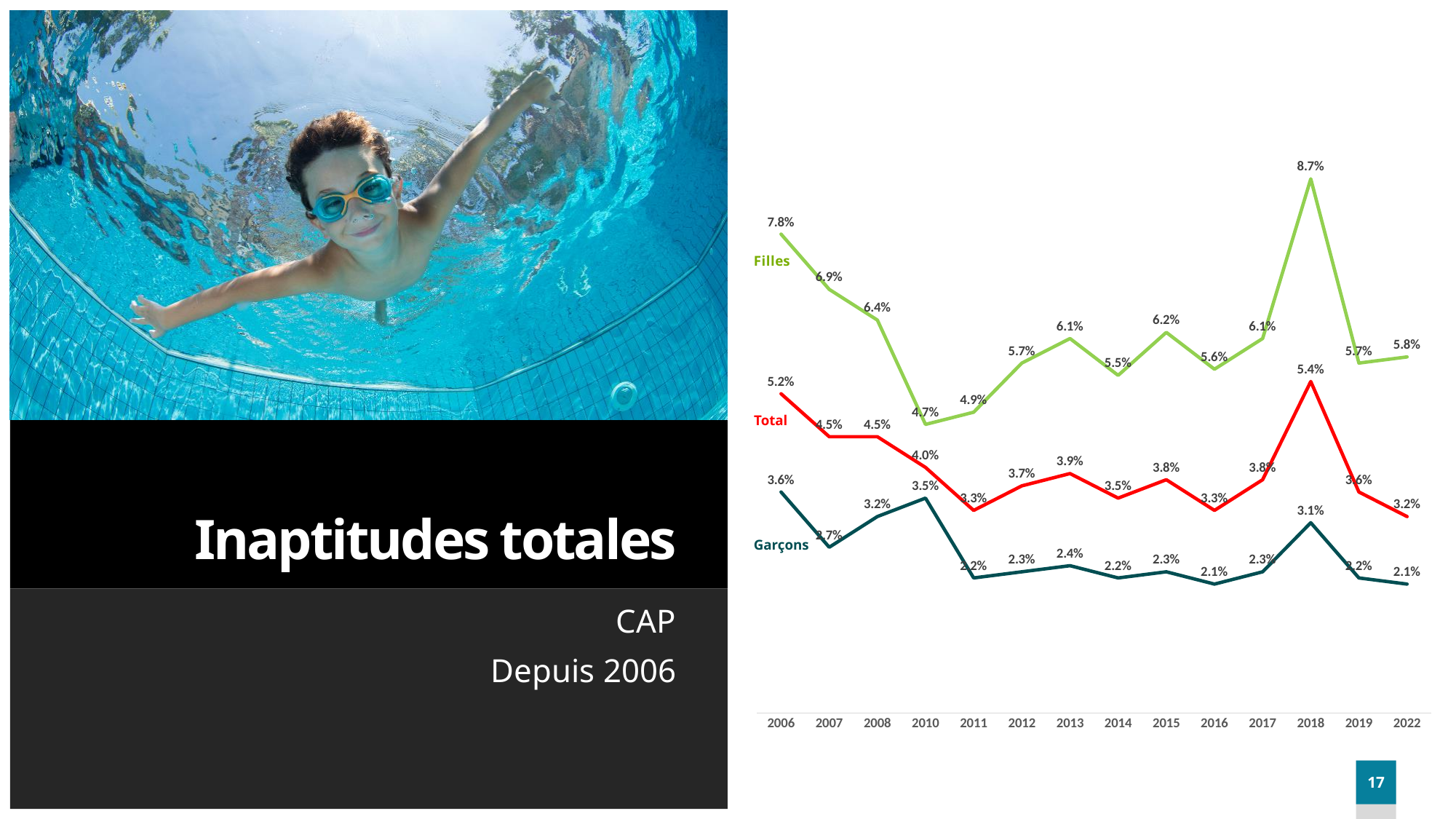
Which is larger for Filles: the value in 2013 or the value in 2015? 2015 How many years are shown on the x axis? 14 Does the Total series rise or fall from 2018 to 2022? Fall In which year does the Total series reach its lowest value? 2022 In which year does the Filles series reach its highest value? 2018 How many series are plotted on the chart? 3 By how many percentage points did the Filles value fall between 2006 and 2022? 2.0 percentage points What kind of chart is shown on the slide? Line chart What is the value for Total in 2006? 5.2% What is the value for Filles in 2018? 8.7% What is the value for Garçons in 2022? 2.1% Which series is drawn in red? Total